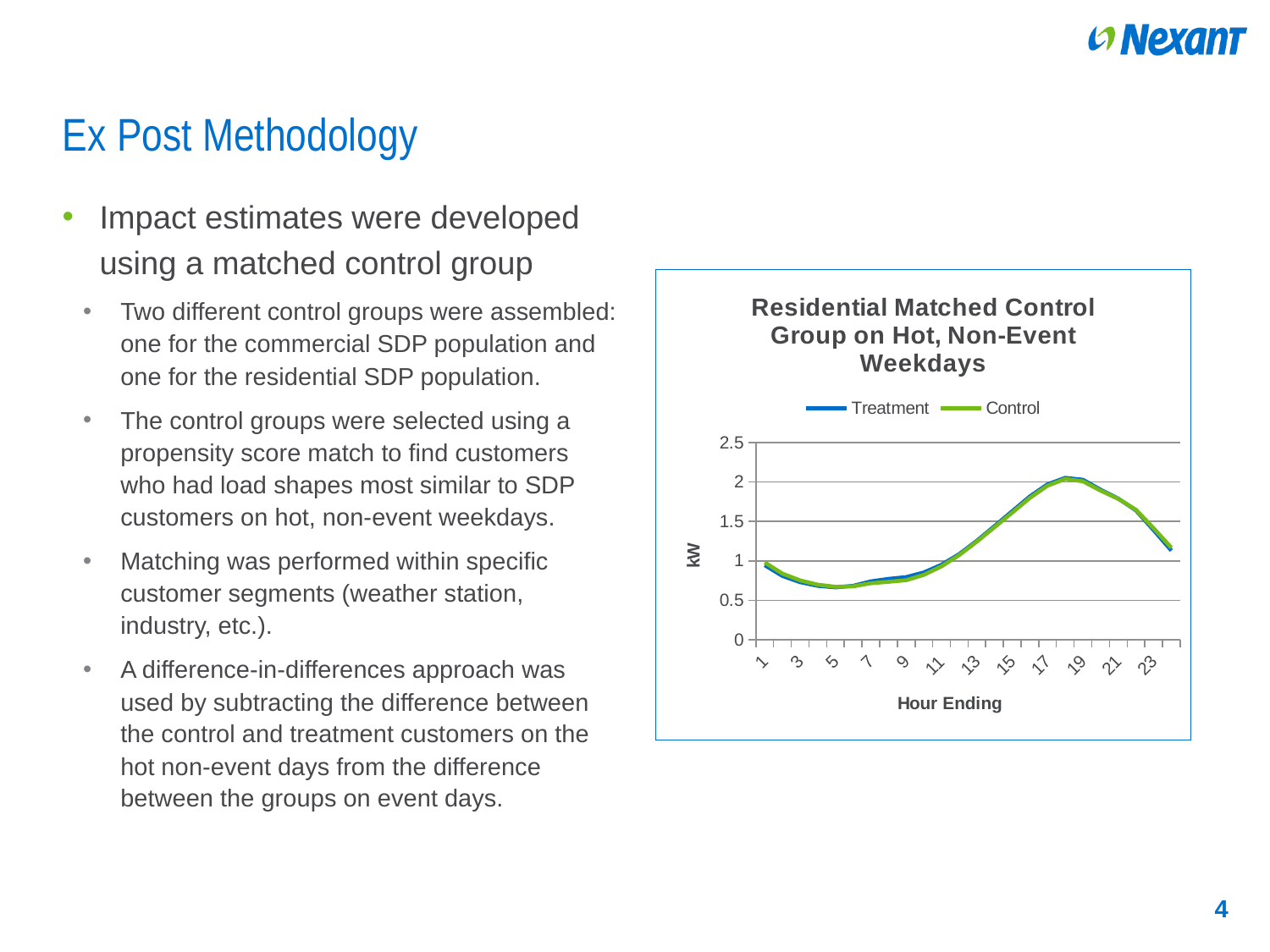
Is the Control value at hour ending 21 greater or less than 1.5? greater Is the Treatment value at hour ending 5 greater or less than 1? less Do the Treatment values rise or fall between hour ending 7 and hour ending 17? rise What kind of chart is shown on the slide? line chart Is the Treatment value at hour ending 9 greater or less than 1? less How many series does the chart's legend list? 2 Around which hour ending do the Treatment and Control lines reach their lowest values? 5 What is the title of the chart? Residential Matched Control Group on Hot, Non-Event Weekdays Do the Control values rise or fall between hour ending 19 and hour ending 23? fall What is the label on the chart's vertical axis? kW